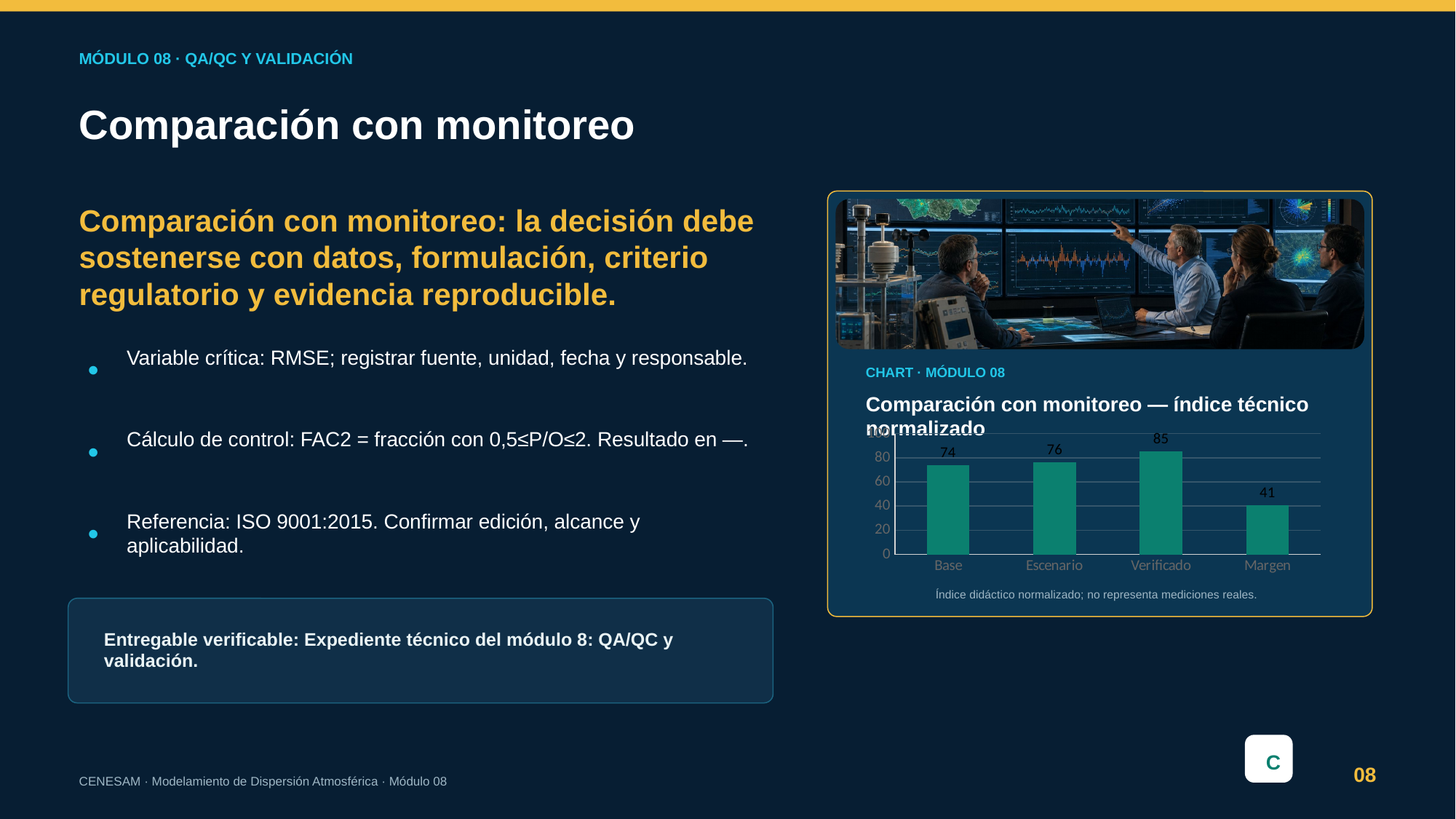
Is the value for Margen greater or less than 60? less What kind of chart is shown on the slide? bar chart What is the difference between the values for Escenario and Base? 2 What is the difference between the values for Verificado and Margen? 44 What is the value for Escenario? 76 Which is larger, the value for Verificado or the value for Base? Verificado What is the value for Base? 74 How many categories are shown on the x axis? 4 What is the value for Verificado? 85 Which category has the lowest value? Margen Which category has the highest value? Verificado What is the value for Margen? 41